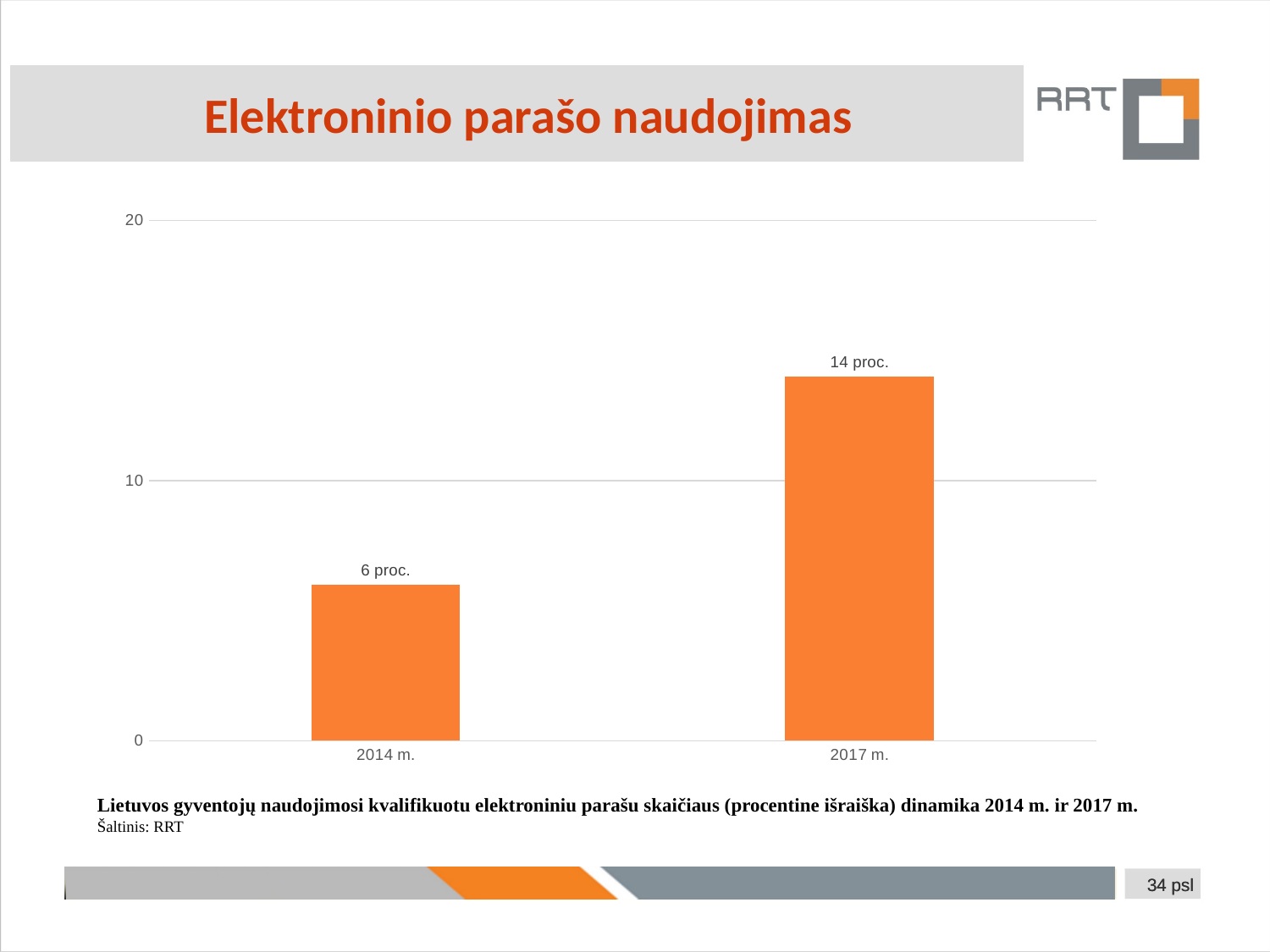
Is the value for 2014 m. greater or less than 10? less What is the title of the slide? Elektroninio parašo naudojimas How many categories are shown on the x axis? 2 Is the value for 2017 m. greater or less than 10? greater What is the value for 2014 m.? 6 proc. What is the value for 2017 m.? 14 proc. What is the difference between the values for 2017 m. and 2014 m.? 8 proc. What kind of chart is shown on the slide? bar chart Which year has the lower value? 2014 m. Which year has the higher value? 2017 m. Is the value for 2017 m. larger or smaller than the value for 2014 m.? larger Do the values rise or fall from 2014 m. to 2017 m.? rise